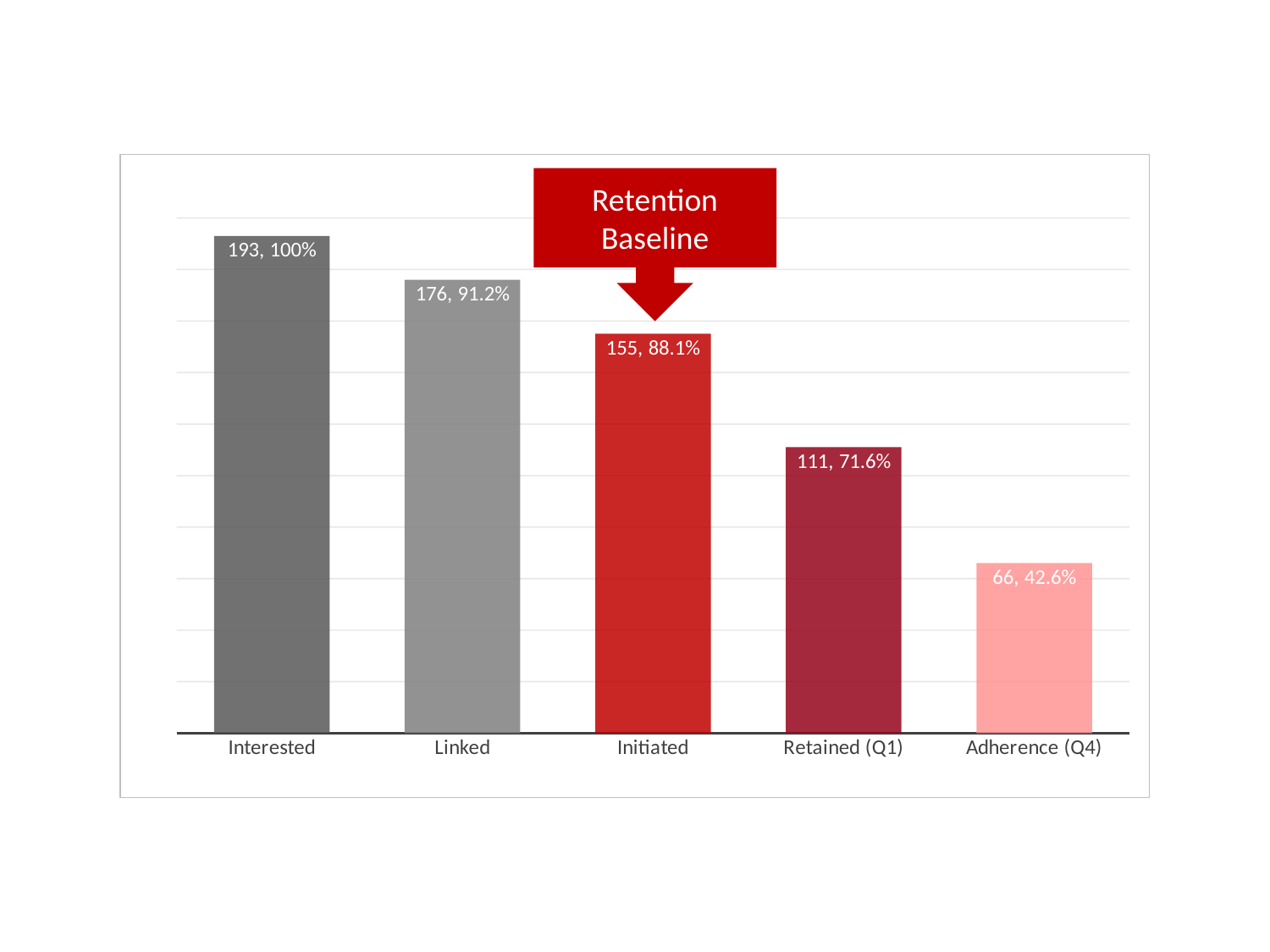
How many categories are shown on the x axis? 5 What count is shown for Retained (Q1)? 111 Which is larger, the count for Initiated or the count for Retained (Q1)? Initiated What is the data label shown on the Adherence (Q4) bar? 66, 42.6% What is the difference in count between Interested and Linked? 17 Which category has the lowest value? Adherence (Q4) What is the data label shown on the Interested bar? 193, 100% Which category has the highest value? Interested What kind of chart is shown on the slide? Bar chart What is the difference in count between Retained (Q1) and Adherence (Q4)? 45 What percentage is shown for the Initiated category? 88.1% What count is shown for the Linked category? 176